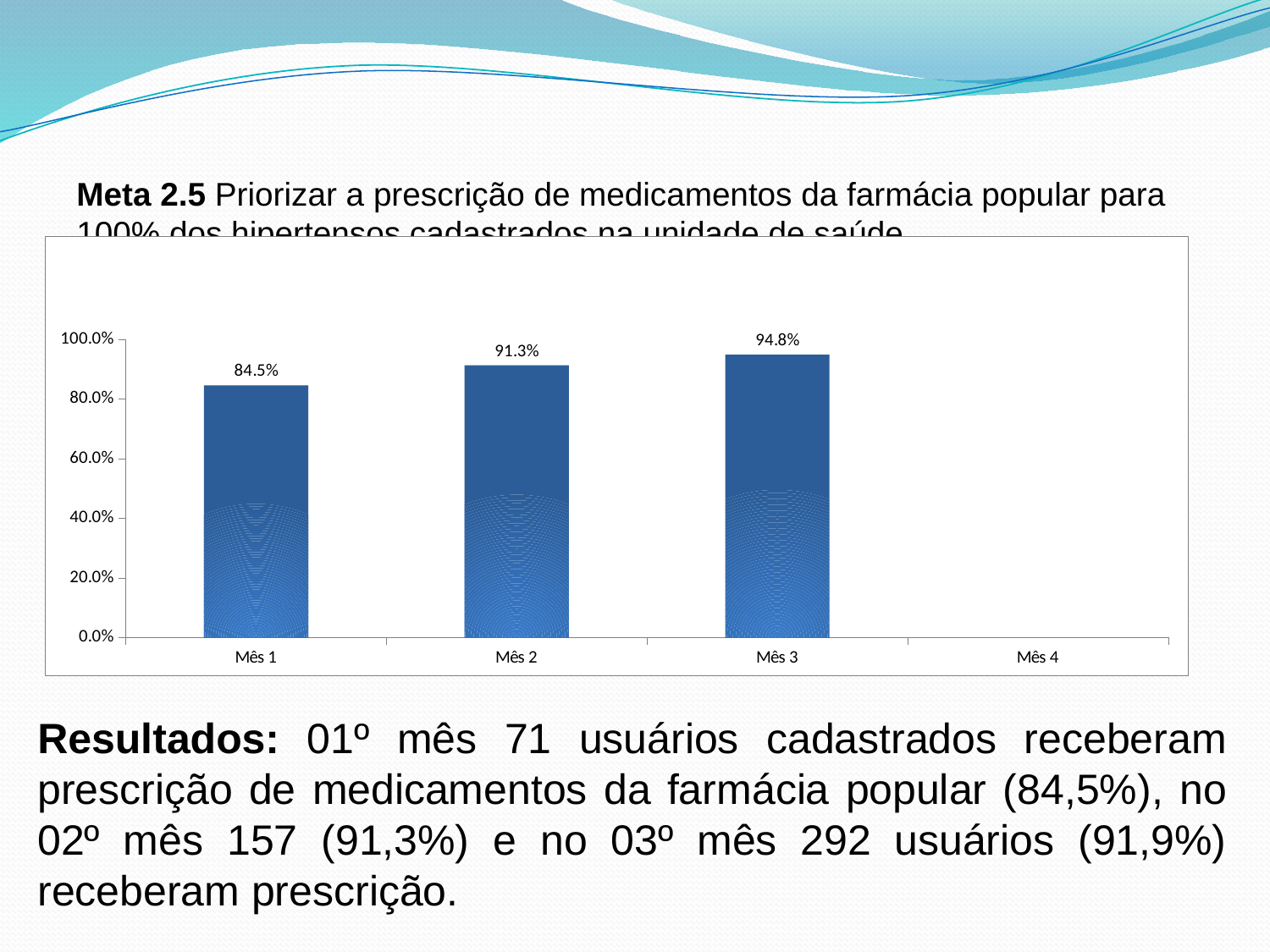
Which month with a plotted bar has the lowest value? Mês 1 What is the value for Mês 1? 84.5% How many bars are plotted in the chart? 3 What is the value for Mês 2? 91.3% Do the values rise or fall from Mês 1 to Mês 3? rise What is the value for Mês 3? 94.8% What kind of chart is shown on the slide? bar chart Which is larger, the value for Mês 2 or the value for Mês 3? Mês 3 Is the value for Mês 1 greater or less than 80.0%? greater What is the difference between the values for Mês 2 and Mês 1? 6.8 percentage points What is the difference between the values for Mês 3 and Mês 1? 10.3 percentage points Which month has the highest value? Mês 3